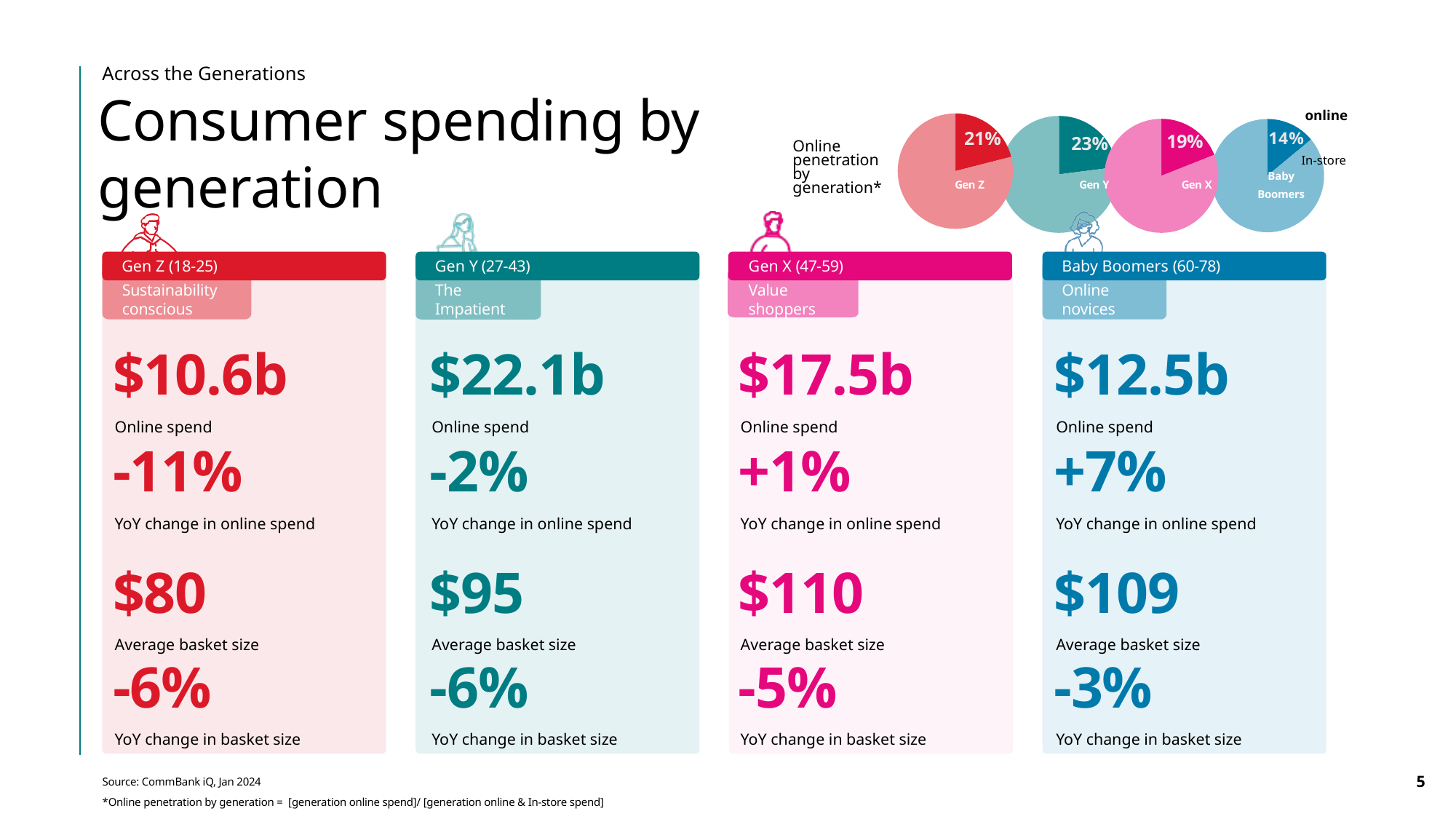
In the online penetration by generation pie charts, what is the online penetration for Gen X? 19% In the online penetration by generation pie charts, how many percentage points higher is Gen Y's online penetration than Baby Boomers'? 9 percentage points In the online penetration by generation pie charts, which generation has the lowest online penetration? Baby Boomers In the online penetration by generation pie charts, what is the online penetration for Gen Y? 23% In the online penetration by generation pie charts, which has a larger online penetration, Gen Z or Gen X? Gen Z In the online penetration by generation pie charts, what is the online penetration for Gen Z? 21% How many pie charts are shown for online penetration by generation? 4 In the online penetration by generation pie charts, which generation has the highest online penetration? Gen Y In the online penetration by generation pie charts, what is the online penetration for Baby Boomers? 14% What two categories does the legend of the online penetration pie charts list? online and In-store In the online penetration by generation pie charts, what is the difference between Gen Y's and Gen Z's online penetration? 2 percentage points What type of chart is used to show online penetration by generation? Pie chart